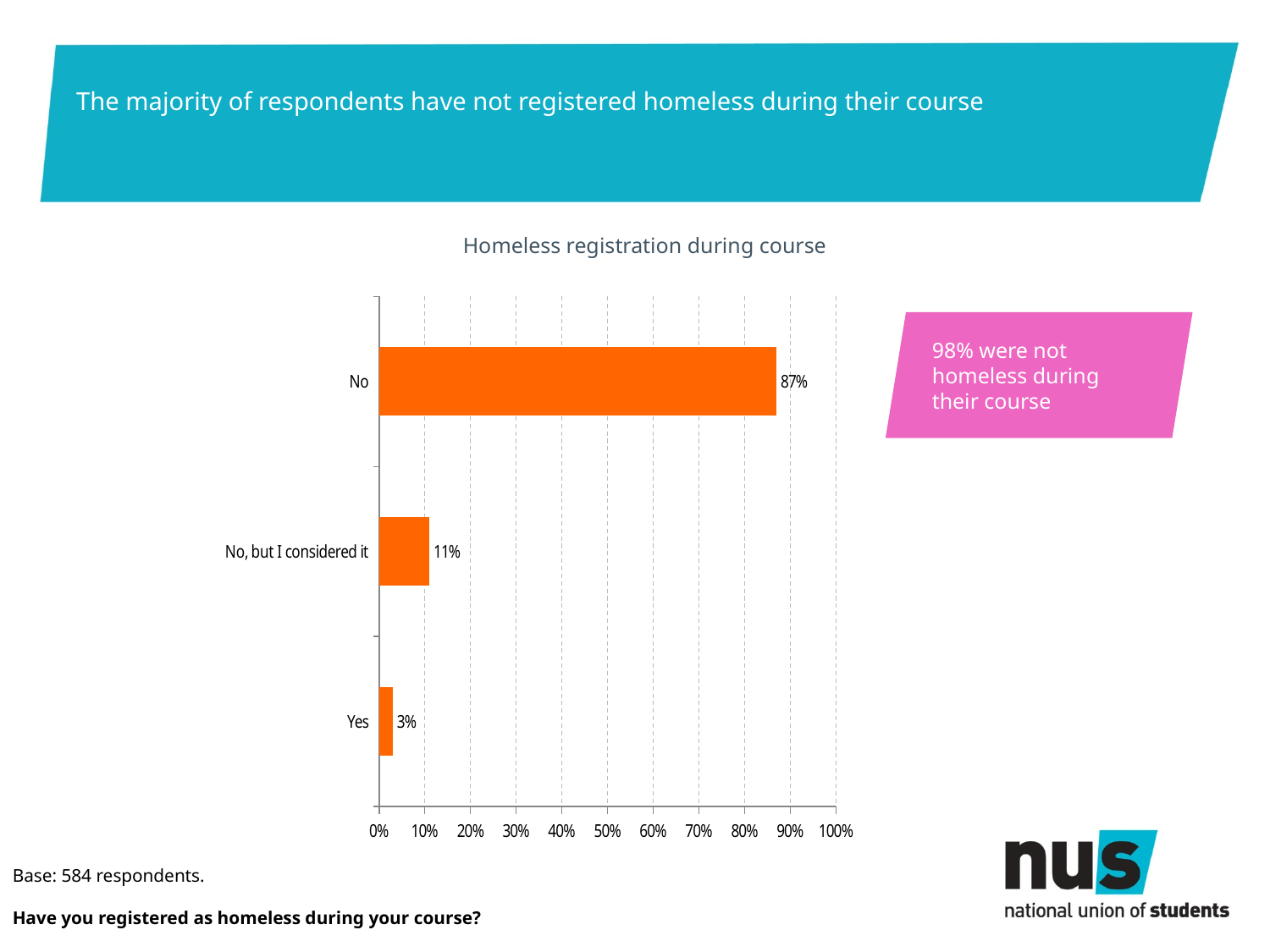
How many categories are shown in the chart? 3 What is the difference between the "No, but I considered it" and "Yes" values? 8% Which is larger, the value for "No, but I considered it" or the value for "Yes"? No, but I considered it What is the title of the chart? Homeless registration during course What percentage of respondents answered "No, but I considered it"? 11% Which category has the highest value? No What is the difference between the "No" and "No, but I considered it" values? 76% What percentage of respondents answered "Yes"? 3% Is the value for "No" greater or less than 80%? greater What kind of chart is shown on the slide? Bar chart Which category has the lowest value? Yes What percentage of respondents answered "No"? 87%